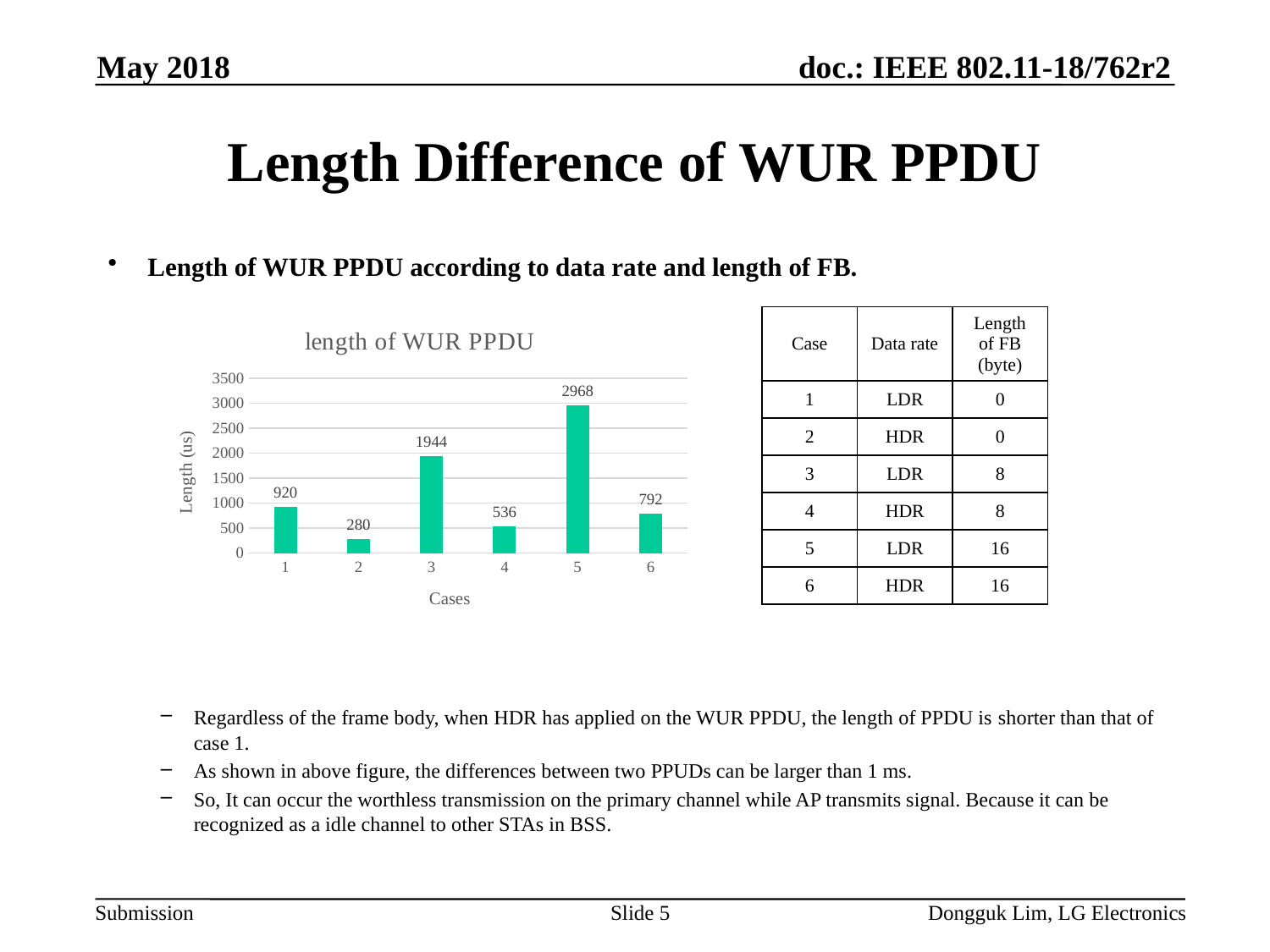
What is the difference in length between case 3 and case 4? 1408 Which has a larger length of WUR PPDU, case 1 or case 6? case 1 What is the length of WUR PPDU for case 4? 536 What is the difference in length between case 5 and case 6? 2176 Which case has the lowest length of WUR PPDU? 2 What is the title of the chart? length of WUR PPDU What is the length of WUR PPDU for case 5? 2968 What kind of chart is shown on the slide? bar chart How many cases are plotted in the chart? 6 Which case has the highest length of WUR PPDU? 5 Is the value for case 3 greater or less than 1500? greater What is the length of WUR PPDU for case 1? 920